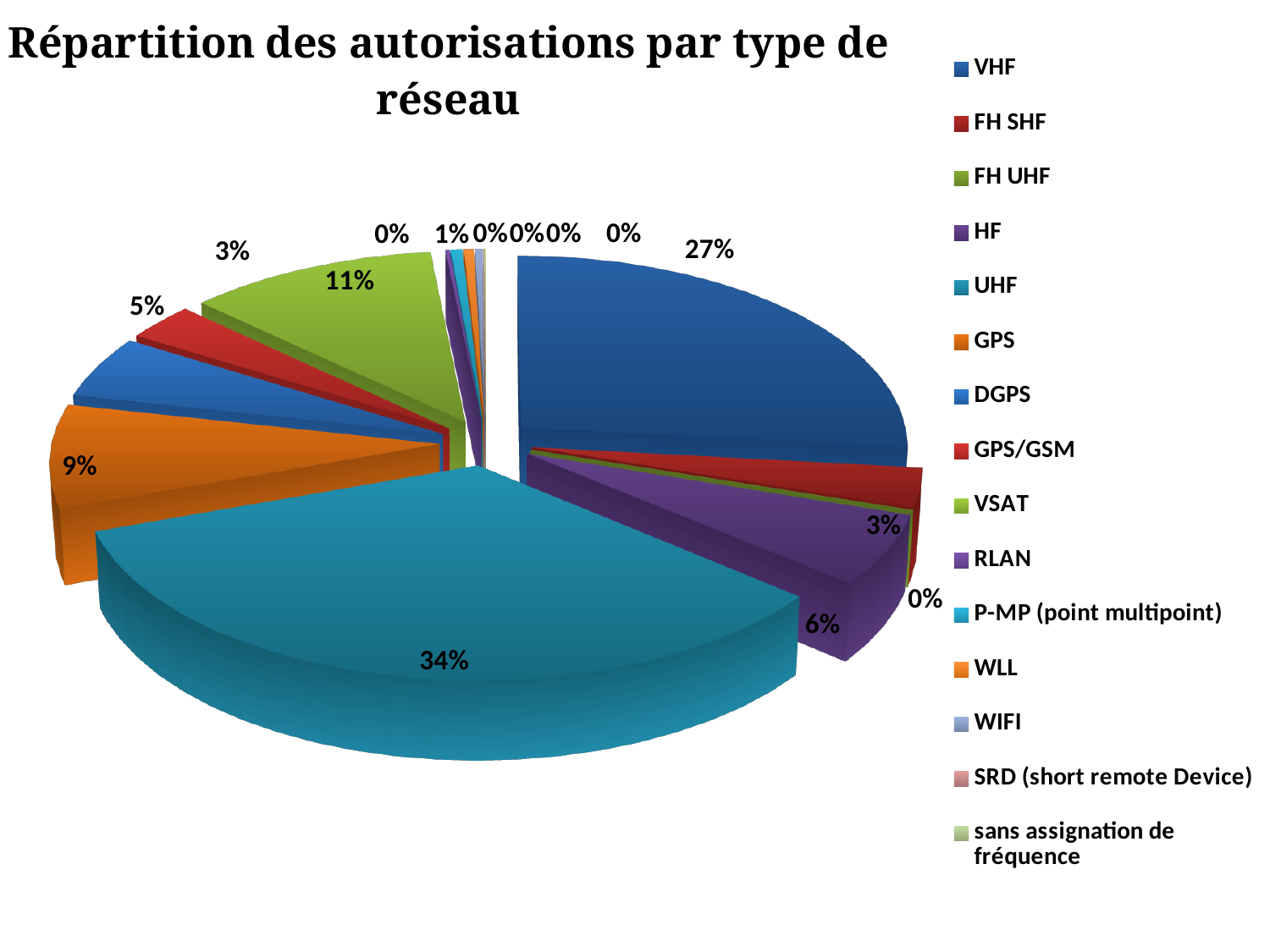
What percentage is shown for VSAT? 11% How many percentage points larger is the UHF share than the VHF share? 7 What percentage is shown for DGPS? 5% What is the title of the chart? Répartition des autorisations par type de réseau How many network types are listed in the legend? 15 What percentage is shown for HF? 6% What type of chart is shown on the slide? pie chart What share of authorisations does UHF account for? 34% Which network type has the largest share of authorisations? UHF What share of authorisations does VHF account for? 27% What percentage is shown for GPS? 9% Which has a larger share, VSAT or GPS? VSAT